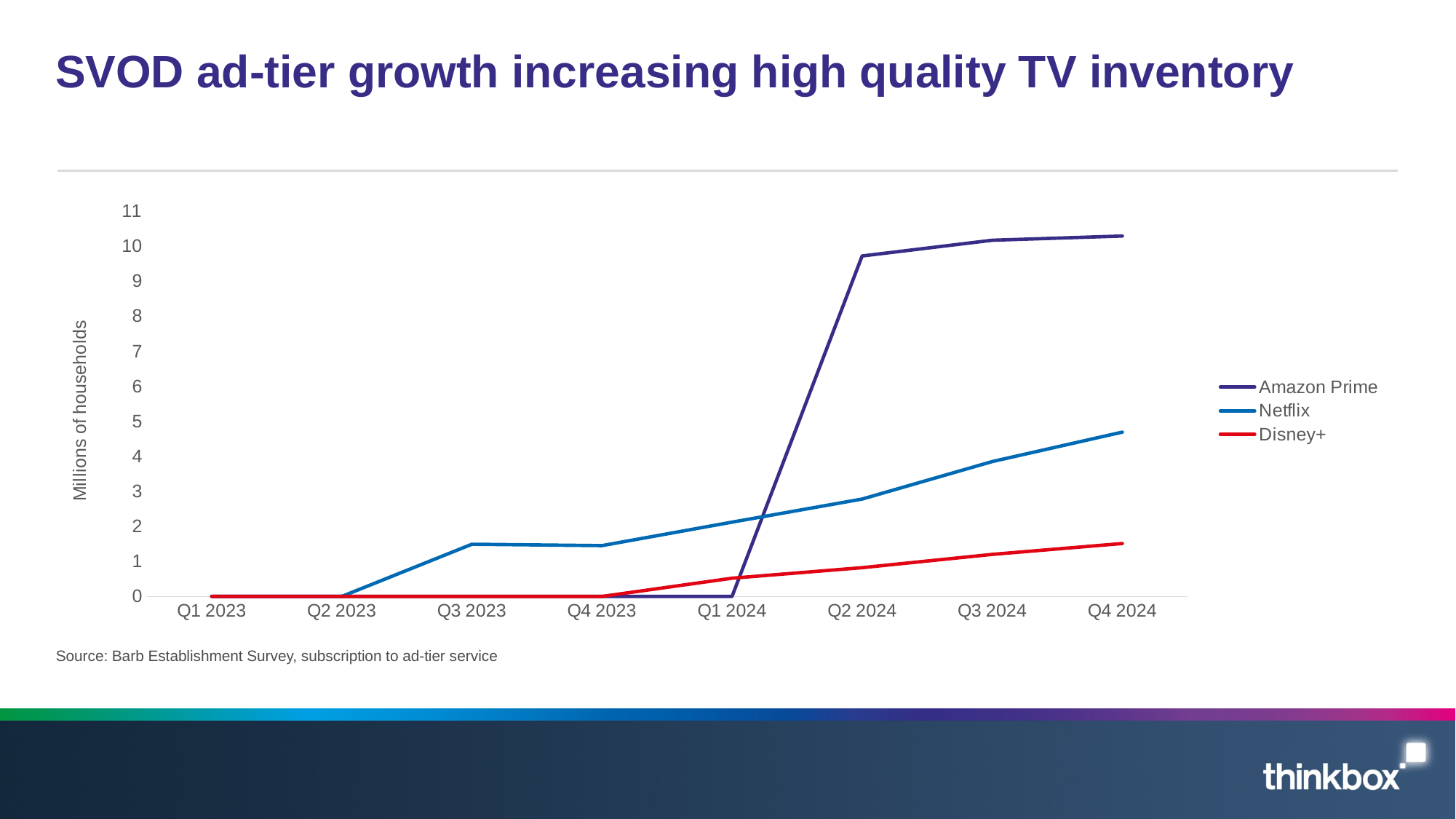
Which series has the lowest value in Q4 2024? Disney+ Which series has the highest value in Q4 2024? Amazon Prime Which is larger in Q1 2024, Netflix or Amazon Prime? Netflix Does the Netflix line rise or fall from Q4 2023 to Q4 2024? rise What kind of chart is shown on the slide? line chart How many quarters are shown along the x axis? 8 Is the value for Disney+ in Q4 2024 greater or less than 2? less What is the value for Amazon Prime in Q1 2024? 0 What is the label on the y axis? Millions of households Is the value for Amazon Prime in Q4 2024 greater or less than 10? greater Is the value for Netflix in Q4 2024 greater or less than 5? less How many series does the legend list? 3